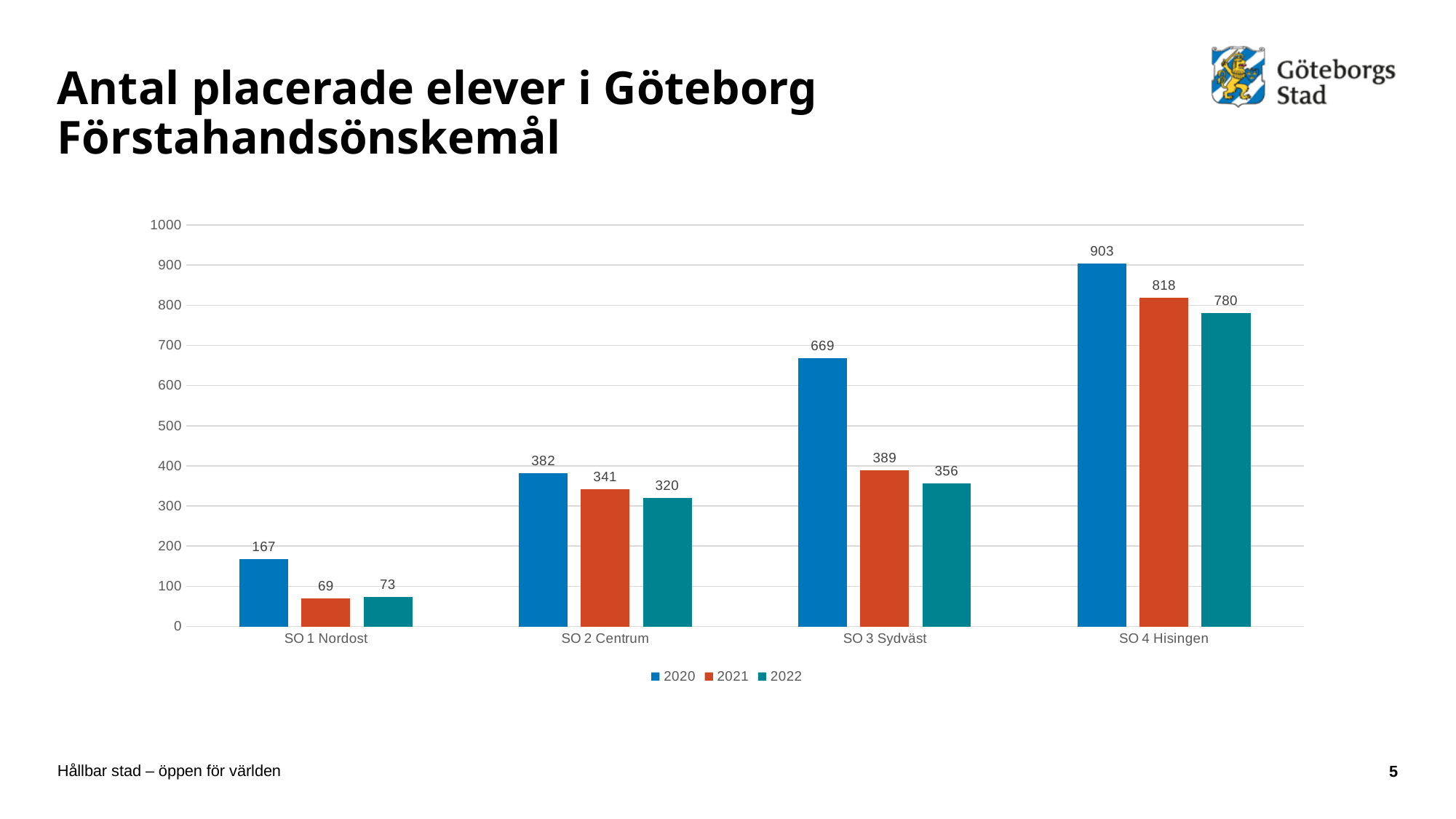
What is the value for SO 1 Nordost in 2021? 69 What is the value for SO 4 Hisingen in 2020? 903 What is the difference between the 2020 and 2021 values for SO 3 Sydväst? 280 How many series does the legend list? 3 How many categories are shown on the x axis? 4 What kind of chart is shown on the slide? bar chart Which series is shown in blue in the legend? 2020 What is the value for SO 3 Sydväst in 2022? 356 Is the value for SO 4 Hisingen in 2022 greater or less than 700? greater Which category has the lowest value in 2022? SO 1 Nordost Which is larger for SO 2 Centrum: the 2021 value or the 2022 value? 2021 Which category has the highest value in 2020? SO 4 Hisingen